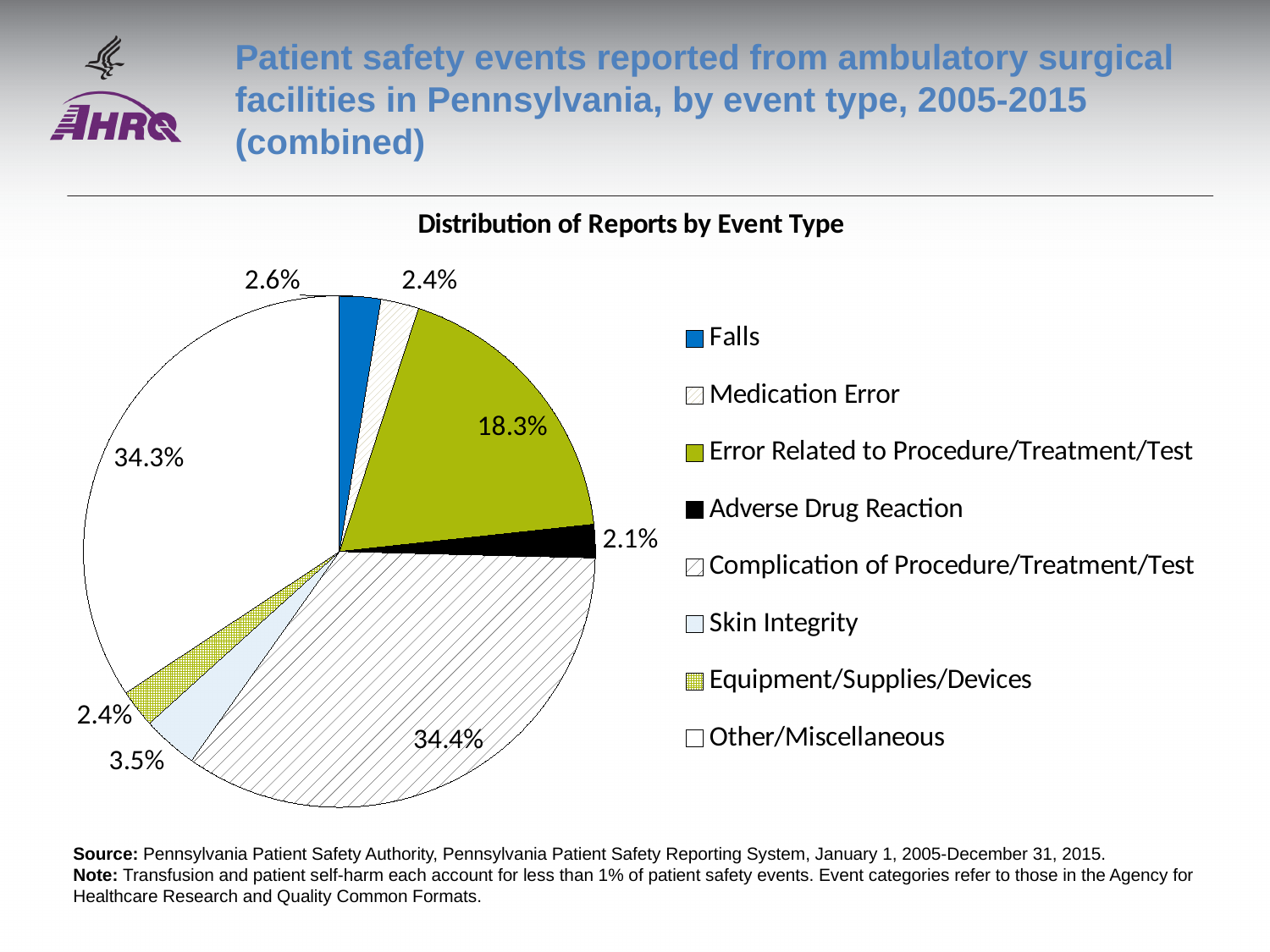
What share of reports is attributed to Complication of Procedure/Treatment/Test? 34.4% Which legend entry is shown in solid black? Adverse Drug Reaction What is the difference in percentage points between Complication of Procedure/Treatment/Test (34.4%) and Error Related to Procedure/Treatment/Test (18.3%)? 16.1 percentage points What percentage of reports are Falls? 2.6% What type of chart is shown on the slide? Pie chart What percentage of reports are Adverse Drug Reaction events? 2.1% What is the title of the chart? Distribution of Reports by Event Type What share of reports is attributed to Other/Miscellaneous? 34.3% What percentage of reports are Skin Integrity events? 3.5% What share of reports is attributed to Error Related to Procedure/Treatment/Test? 18.3% Which is larger: the share for Error Related to Procedure/Treatment/Test or the share for Complication of Procedure/Treatment/Test? Complication of Procedure/Treatment/Test How many event types does the legend list? 8